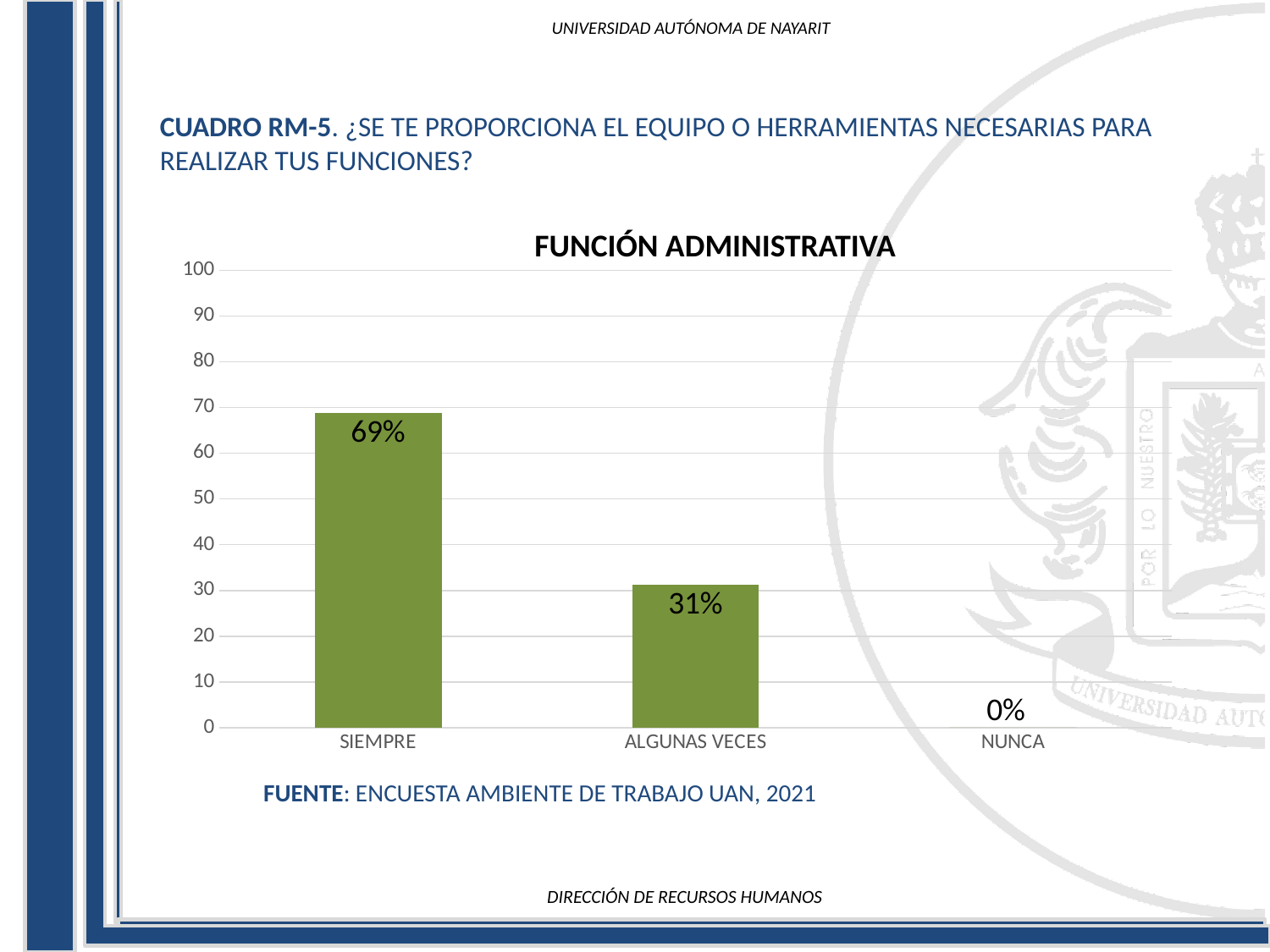
Which is larger, the value for SIEMPRE or the value for ALGUNAS VECES? SIEMPRE Is the value for ALGUNAS VECES greater or less than 40? less Do the values rise or fall from left to right along the x axis? fall How many categories are shown on the x axis? 3 What is the value for NUNCA? 0% What is the value for SIEMPRE? 69% What kind of chart is shown? bar chart Which category has the lowest value? NUNCA What is the difference between the values for SIEMPRE and ALGUNAS VECES? 38% What is the value for ALGUNAS VECES? 31% What is the title of the chart? FUNCIÓN ADMINISTRATIVA Which category has the highest value? SIEMPRE